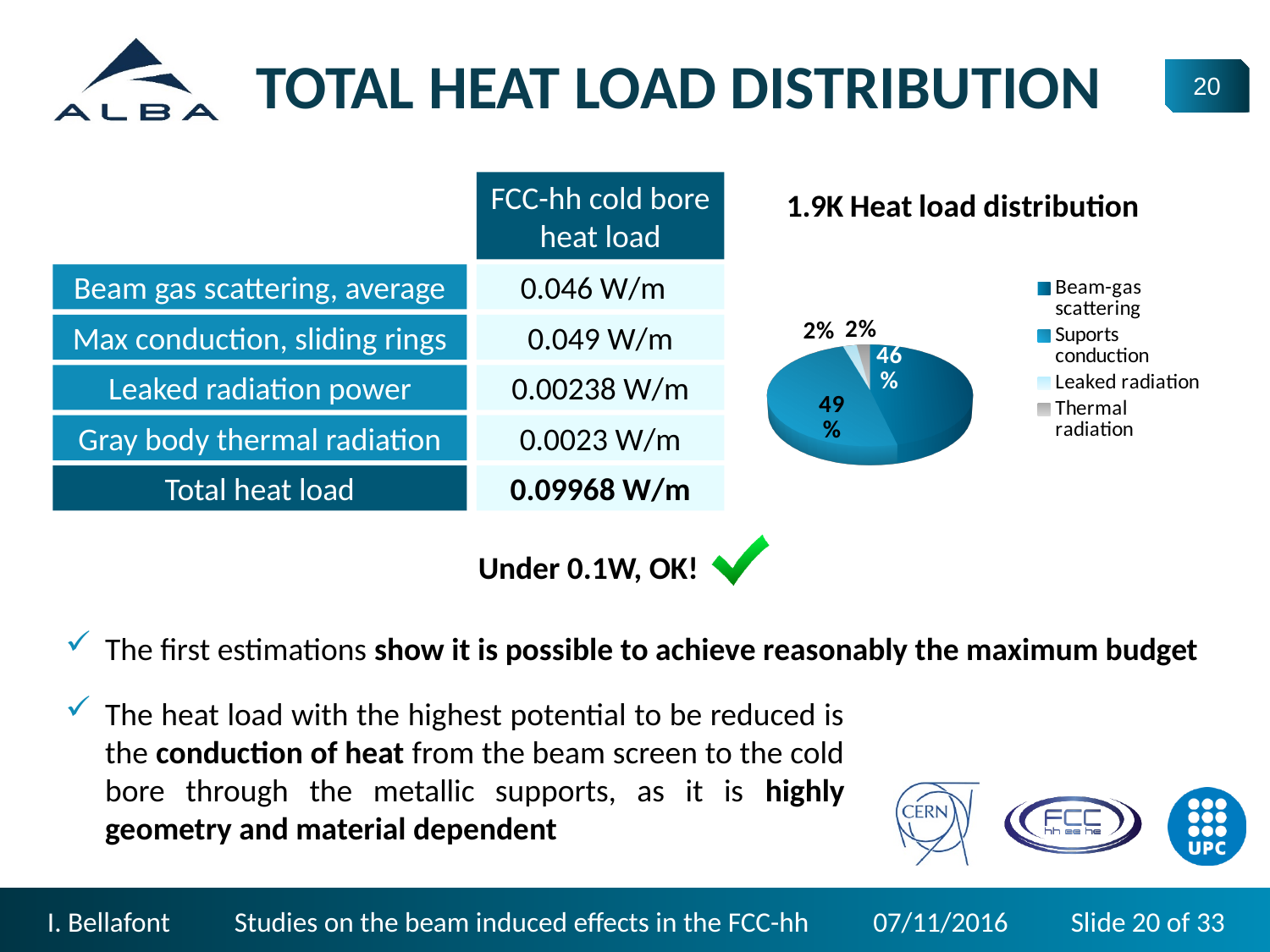
How many entries does the pie chart legend list? 4 What is the combined share of the Leaked radiation and Thermal radiation slices? 4% What share of the pie chart is labelled for Leaked radiation? 2% What kind of chart is shown on the slide? pie chart How many slices does the pie chart have? 4 What is the title of the pie chart? 1.9K Heat load distribution What share of the pie chart is labelled for Beam-gas scattering? 46% Which category has the largest slice in the pie chart? Suports conduction Which entry is listed first in the pie chart legend? Beam-gas scattering What share of the pie chart is labelled for Suports conduction? 49% Which is larger in the pie chart, the Beam-gas scattering slice or the Suports conduction slice? Suports conduction What is the difference between the Suports conduction share and the Beam-gas scattering share in the pie chart? 3%